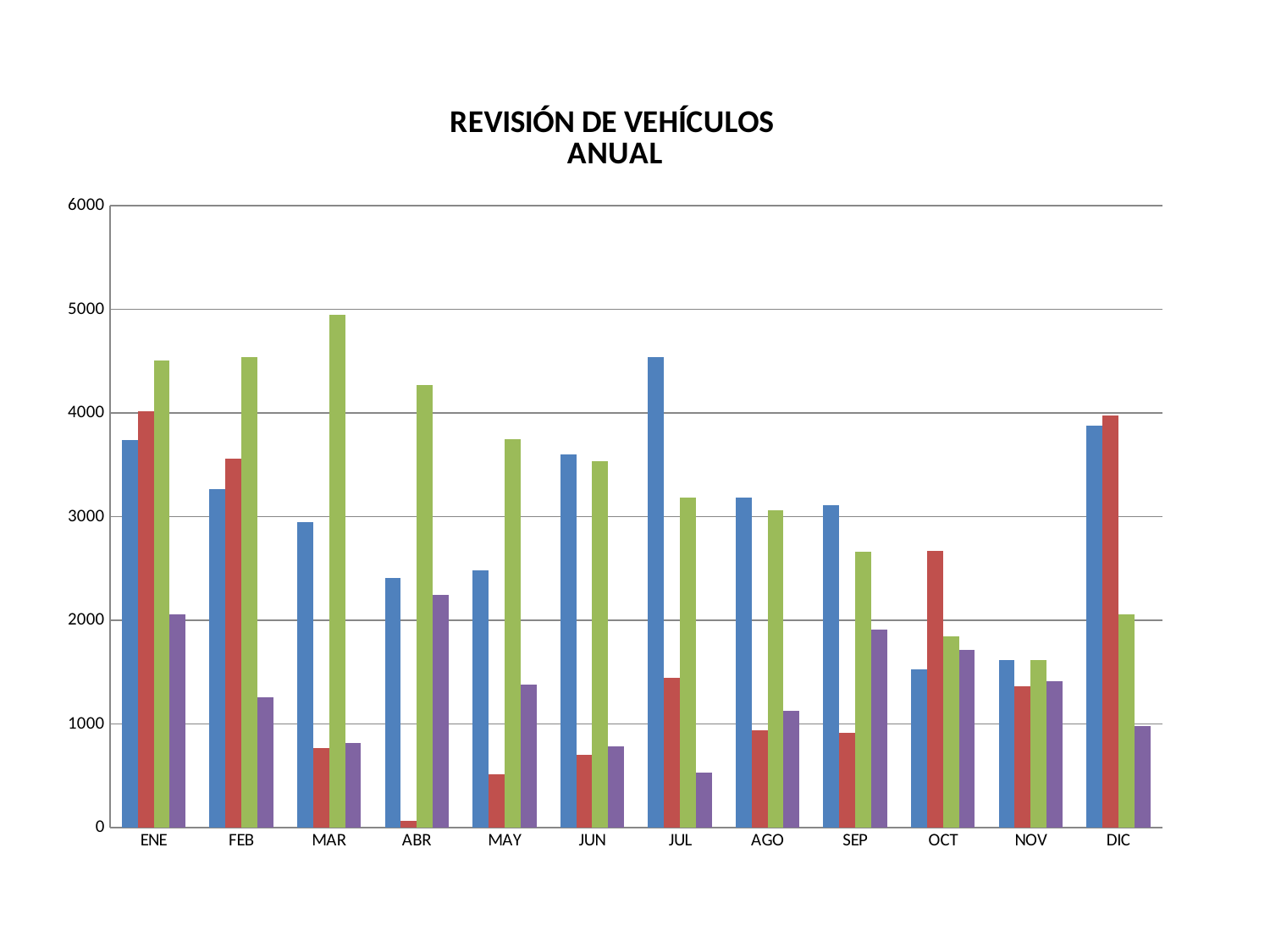
In ABR, which bar is taller, the green bar or the purple bar? the green bar In which month is the blue bar the tallest? JUL In which month is the red bar the shortest? ABR Is the blue bar for OCT greater or less than 2000? less What is the title of the chart? REVISIÓN DE VEHÍCULOS ANUAL In which month is the green bar the tallest? MAR Is the red bar for MAY greater or less than 1000? less Is the green bar for MAR greater or less than 4000? greater How many bars of different colours are plotted for each month? 4 What kind of chart is shown on the slide? bar chart How many months (categories) are shown on the x axis? 12 In OCT, which bar is taller, the red bar or the blue bar? the red bar